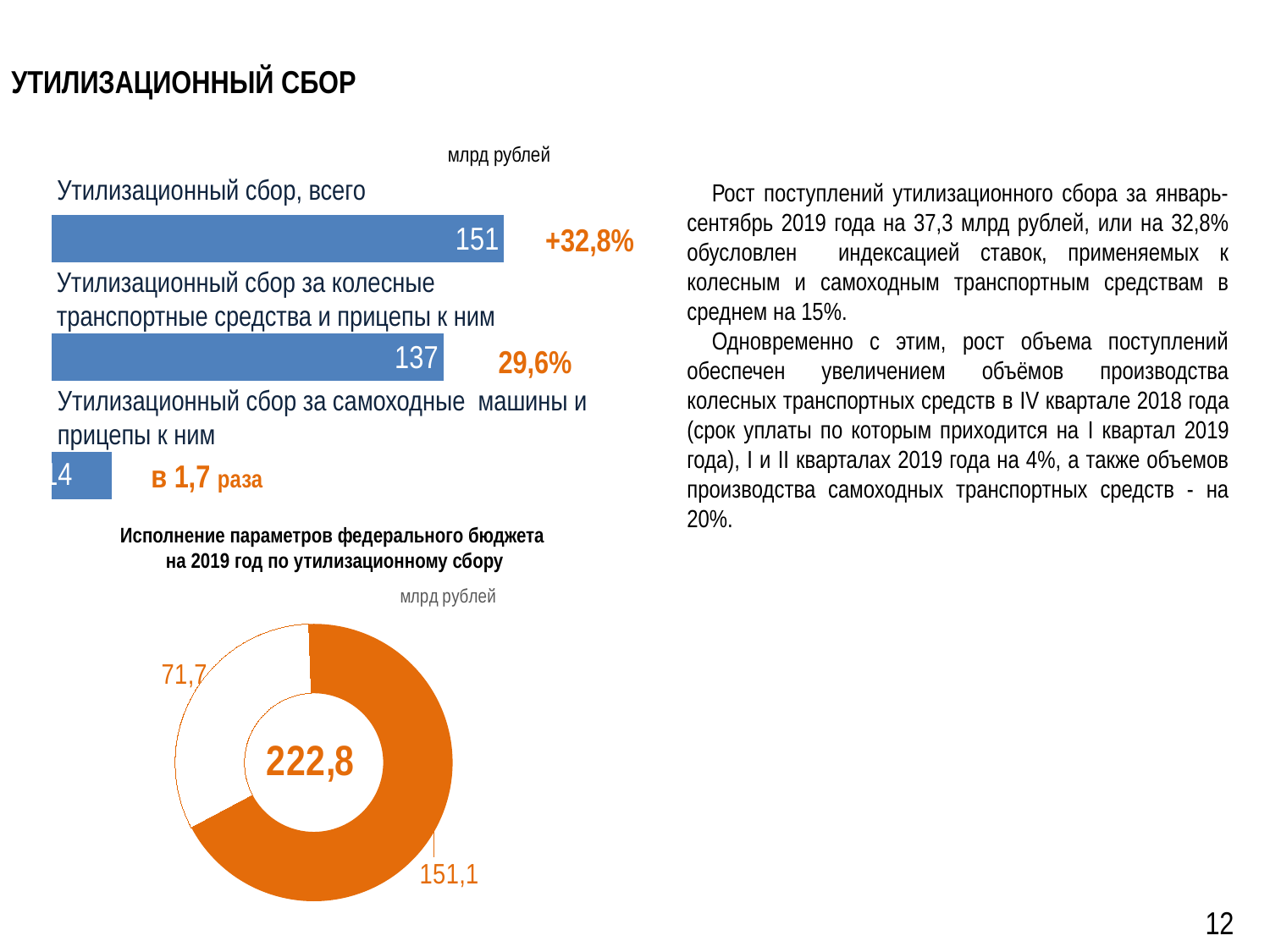
In the top-left bar chart, which category has the lowest value? Утилизационный сбор за самоходные машины и прицепы к ним In the top-left bar chart, what is the value for 'Утилизационный сбор за колесные транспортные средства и прицепы к ним'? 137 What kind of chart is the chart titled 'Исполнение параметров федерального бюджета на 2019 год по утилизационному сбору'? pie chart (donut) What kind of chart is the top-left chart on the slide? bar chart In the top-left bar chart, what growth percentage is shown next to the bar for 'Утилизационный сбор, всего'? +32,8% In the top-left bar chart, what is the value for 'Утилизационный сбор, всего'? 151 In the chart titled 'Исполнение параметров федерального бюджета на 2019 год по утилизационному сбору', what is the difference between the two slices, 151,1 and 71,7? 79,4 How many categories does the top-left bar chart show? 3 In the chart titled 'Исполнение параметров федерального бюджета на 2019 год по утилизационному сбору', what is the value of the larger (orange) slice? 151,1 In the chart titled 'Исполнение параметров федерального бюджета на 2019 год по утилизационному сбору', what total is shown in the centre of the donut? 222,8 In the top-left bar chart, which category has the highest value? Утилизационный сбор, всего In the top-left bar chart, what is the difference between the value for 'Утилизационный сбор, всего' and the value for 'Утилизационный сбор за колесные транспортные средства и прицепы к ним'? 14